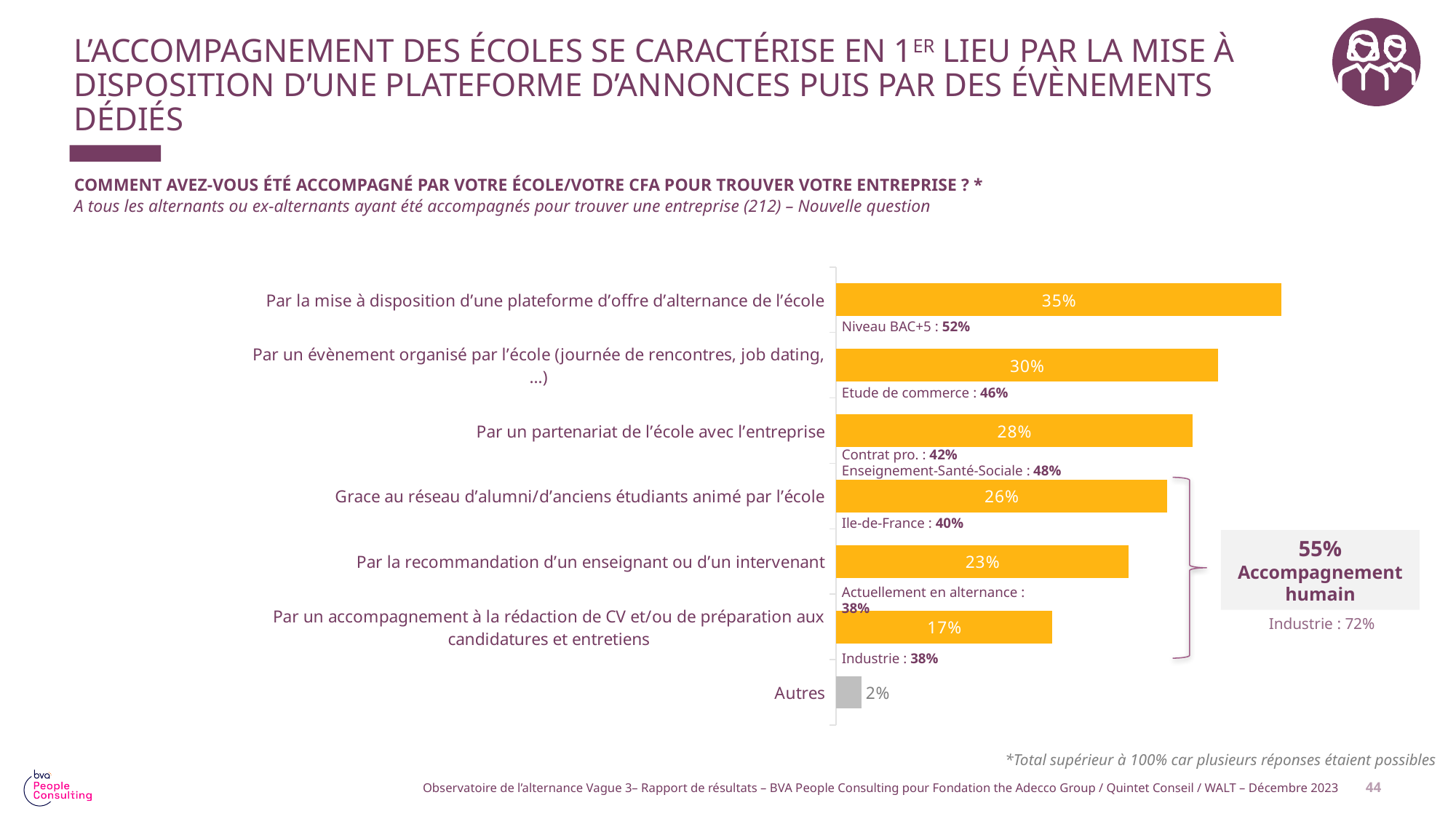
Do the bar values increase or decrease from the top category to the bottom category? Decrease Which category has the highest value in the chart? Par la mise à disposition d'une plateforme d'offre d'alternance de l'école What percentage of respondents were accompanied through the school's platform of work-study offers (plateforme d'offre d'alternance)? 35% What percentage is given in the box labelled 'Accompagnement humain' next to the bracket? 55% What kind of chart is shown on the slide? Bar chart What is the value shown for 'Par un accompagnement à la rédaction de CV et/ou de préparation aux candidatures et entretiens'? 17% How many categories are plotted in the bar chart? 7 What is the value for 'Par un évènement organisé par l'école (journée de rencontres, job dating, …)'? 30% What percentage corresponds to 'Par un partenariat de l'école avec l'entreprise'? 28% What is the difference between the value for the school's platform (35%) and the value for the alumni network (26%)? 9 points Which category has the lowest value in the chart? Autres Which is larger: the value for 'Par la recommandation d'un enseignant ou d'un intervenant' or the value for 'Par un accompagnement à la rédaction de CV et/ou de préparation aux candidatures et entretiens'? Par la recommandation d'un enseignant ou d'un intervenant